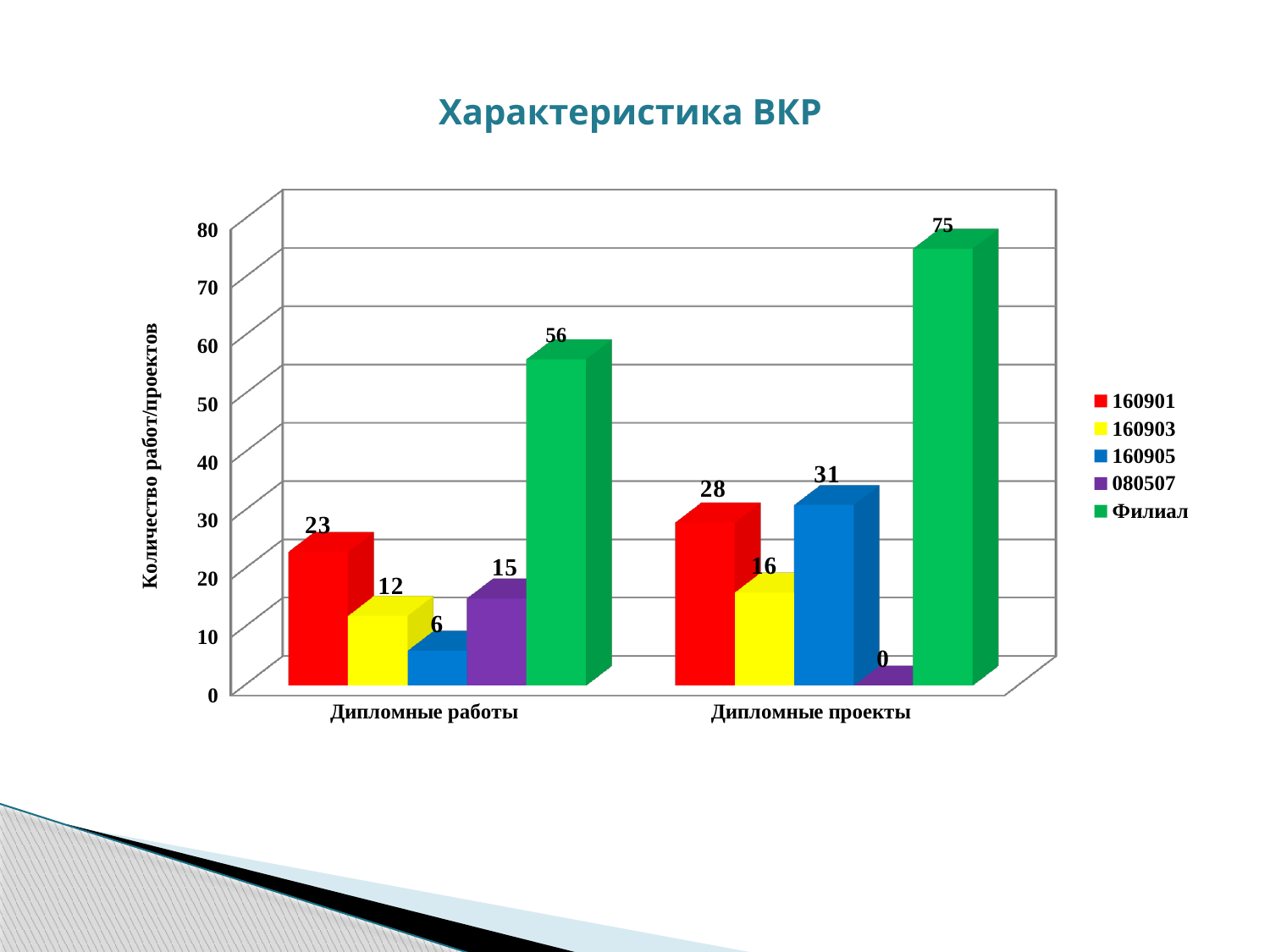
How many series does the legend list? 5 Which series has the lowest value in the Дипломные проекты category? 080507 What is the label of the vertical axis? Количество работ/проектов Which is larger: the value for 160905 in Дипломные работы or in Дипломные проекты? Дипломные проекты What kind of chart is shown on the slide? bar chart Which series has the highest value in the Дипломные работы category? Филиал What is the value for 160901 in the Дипломные работы category? 23 Is the value for 160903 in Дипломные проекты greater or less than 20? less How many categories are shown on the x axis? 2 What is the value for Филиал in the Дипломные проекты category? 75 What is the value for 080507 in the Дипломные проекты category? 0 What is the difference between the Филиал values for Дипломные проекты and Дипломные работы? 19